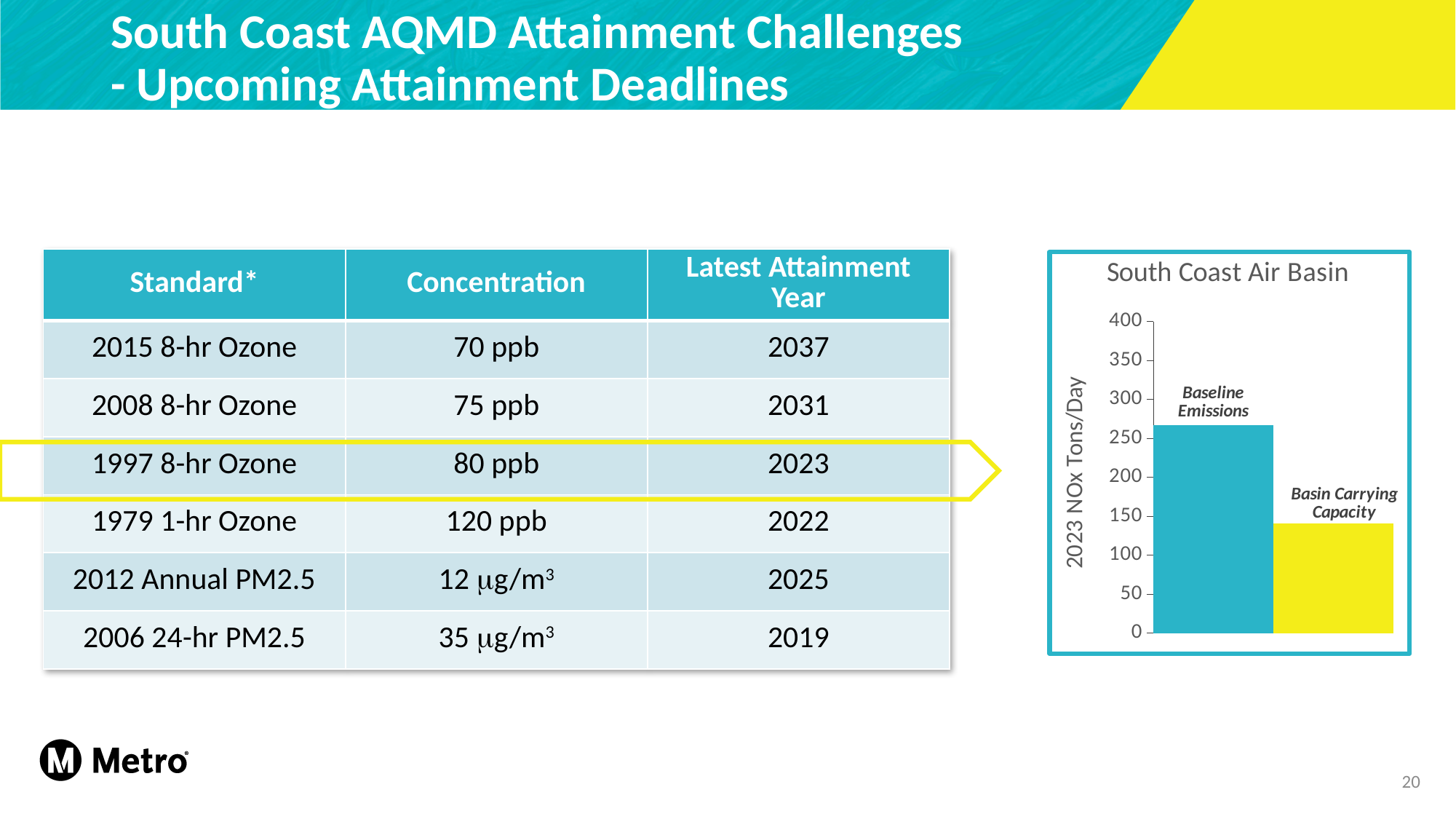
Which bar in the chart is the lowest? Basin Carrying Capacity Is the value for Basin Carrying Capacity greater or less than 200? less What is the title of the chart on the slide? South Coast Air Basin How many bars are plotted in the chart? 2 What kind of chart is shown on the slide? bar chart Is the value for Baseline Emissions greater or less than 250? greater What is the label on the vertical axis of the chart? 2023 NOx Tons/Day Is the value for Baseline Emissions greater or less than 300? less Do the values rise or fall from Baseline Emissions to Basin Carrying Capacity along the x axis? fall Which bar in the chart is the highest? Baseline Emissions Which is larger in the chart, Baseline Emissions or Basin Carrying Capacity? Baseline Emissions